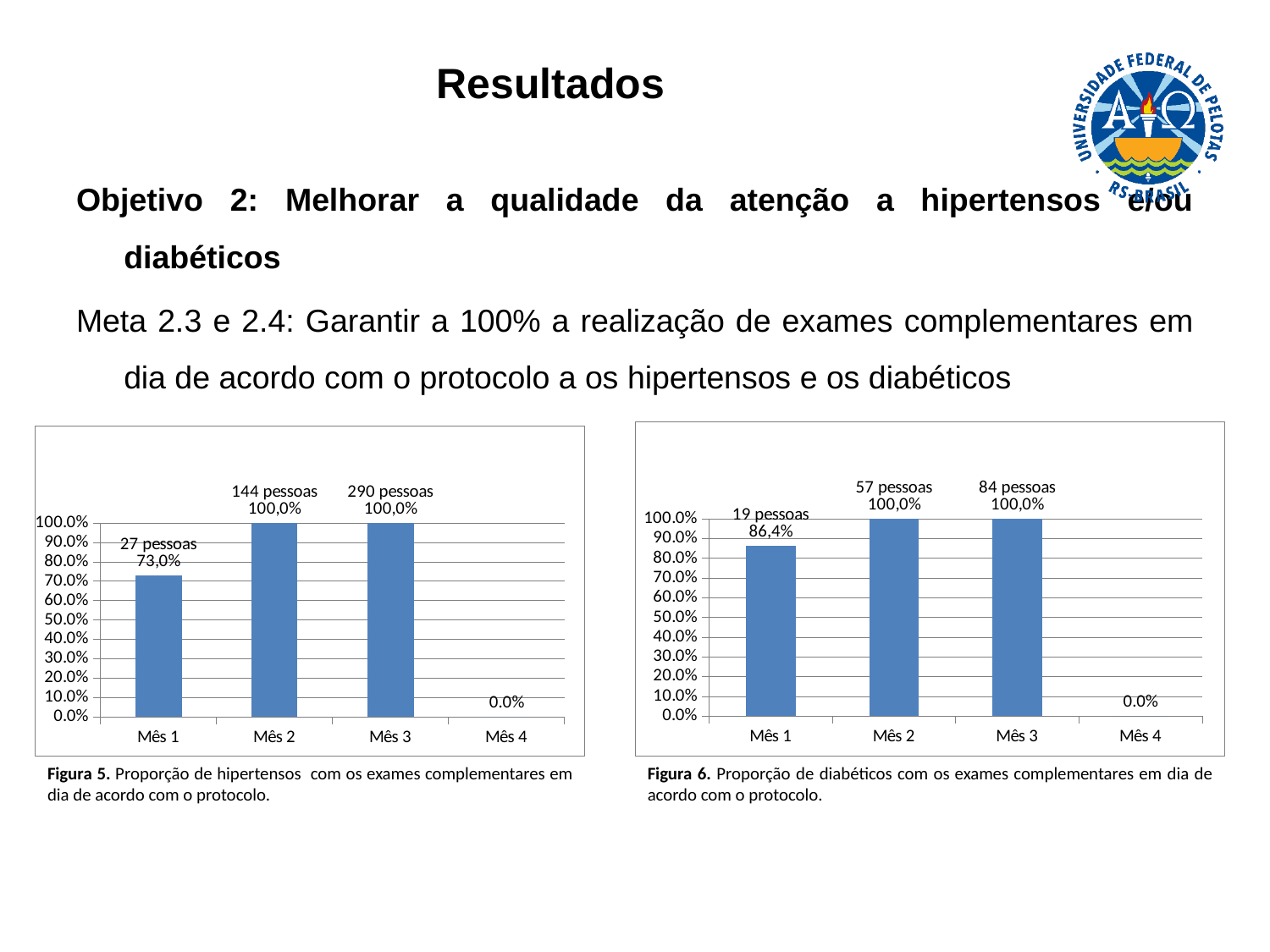
In the left chart (Figura 5, hipertensos), how many people does the label for Mês 3 show? 290 pessoas In the right chart (Figura 6, diabéticos), what is the difference in number of people between Mês 3 and Mês 2? 27 pessoas How many months (categories) are shown on the x axis of the right chart (Figura 6, diabéticos)? 4 What type of chart is the left chart (Figura 5, hipertensos)? Bar chart In the right chart (Figura 6, diabéticos), which is larger, the value for Mês 1 or the value for Mês 3? Mês 3 In the right chart (Figura 6, diabéticos), what is the percentage value for Mês 1? 86,4% In the left chart (Figura 5, hipertensos), which month has the lowest value? Mês 4 In the left chart (Figura 5, hipertensos), is the value for Mês 1 greater or less than 80.0%? less In the left chart (Figura 5, hipertensos), what is the percentage value for Mês 1? 73,0% In the right chart (Figura 6, diabéticos), how many people does the label for Mês 2 show? 57 pessoas In the right chart (Figura 6, diabéticos), what is the value shown for Mês 4? 0.0% In the left chart (Figura 5, hipertensos), what is the difference in percentage between Mês 2 and Mês 1? 27,0%